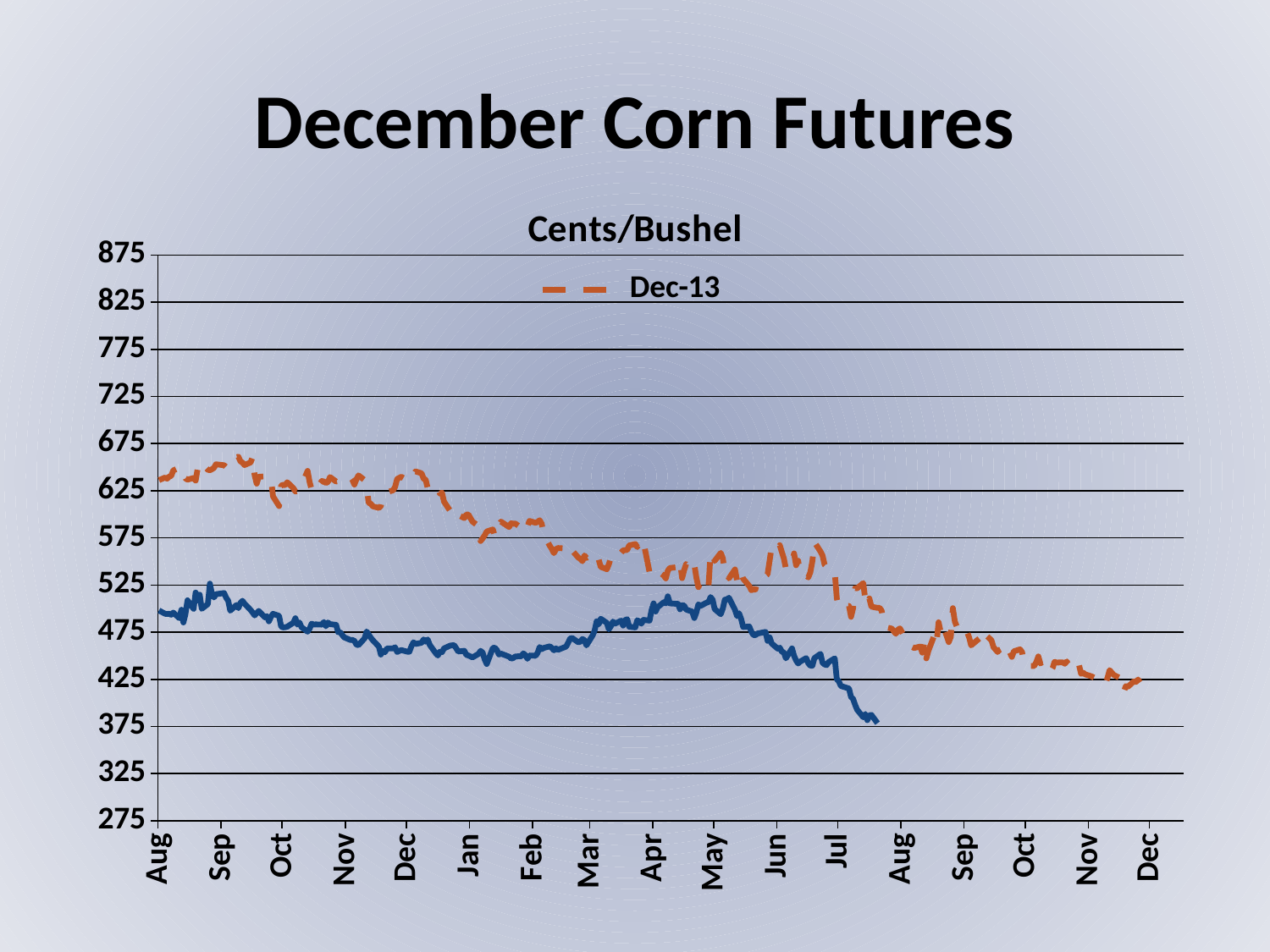
Is the Dec-13 value at the first Aug greater or less than 600? greater What is the title printed above the chart's plot area? Cents/Bushel At the first Aug on the x axis, which is higher: the Dec-13 dashed line or the solid blue line? Dec-13 Is the Dec-13 value at Nov (second Nov on the axis) greater or less than 475? less Is the Dec-13 value at Mar greater or less than 575? less Does the solid blue line overall rise or fall from the first Aug to its end near Jul? fall How many series does the chart legend list? 1 What kind of chart is shown on the slide? line chart What is the name of the series shown in the legend? Dec-13 Does the Dec-13 series overall rise or fall from the first Aug to Dec on the x axis? fall How many month labels are shown along the x axis? 17